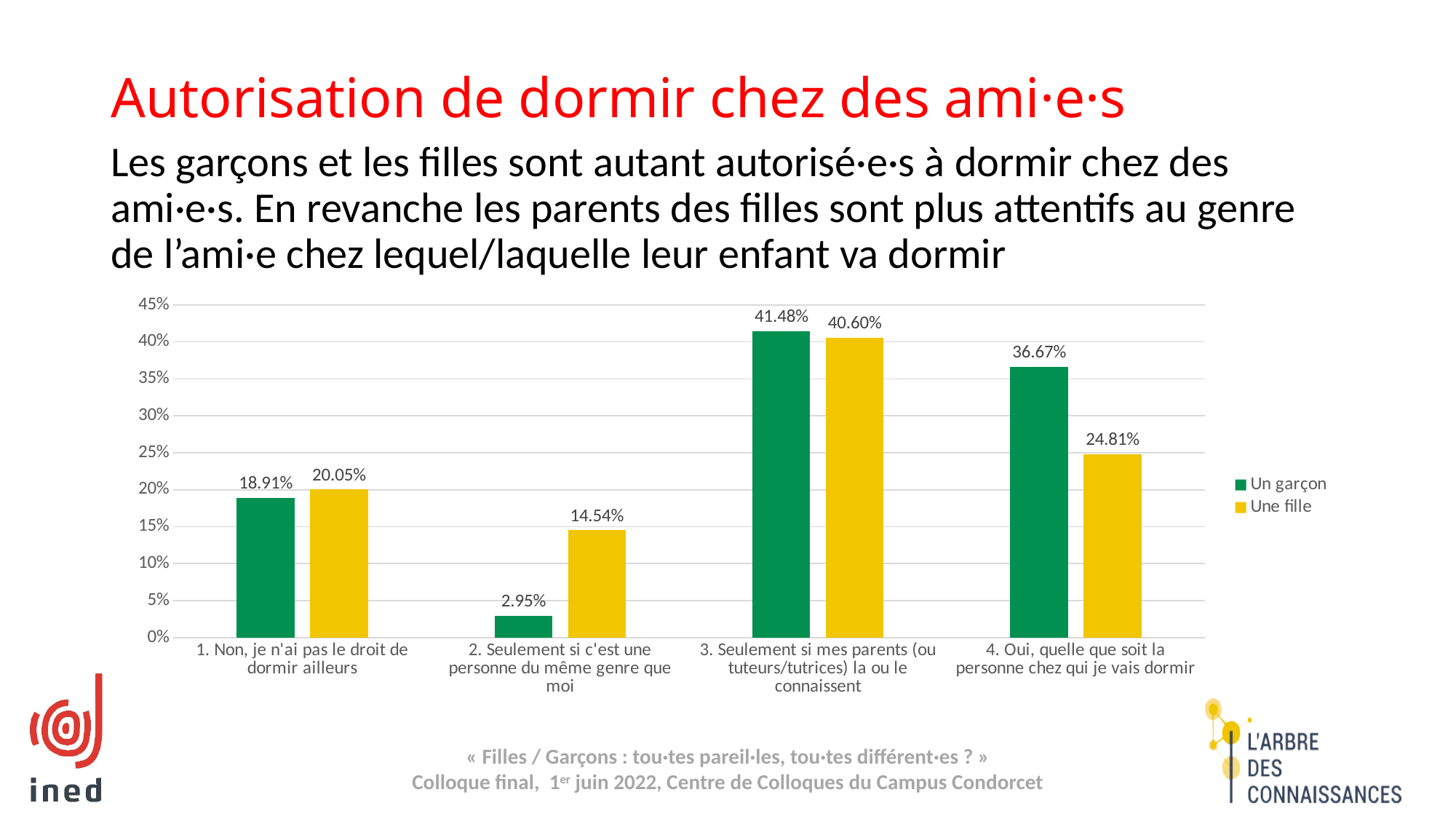
Which category has the lowest value for the "Une fille" series? 2. Seulement si c'est une personne du même genre que moi In category "4. Oui, quelle que soit la personne chez qui je vais dormir", which series has the larger value, "Un garçon" or "Une fille"? Un garçon How many series does the chart legend list? 2 What is the difference between the "Un garçon" and "Une fille" values in category "4. Oui, quelle que soit la personne chez qui je vais dormir"? 11.86 percentage points What type of chart is shown on the slide? Bar chart What is the value for "Un garçon" in category "2. Seulement si c'est une personne du même genre que moi"? 2.95% Which category has the highest value for the "Un garçon" series? 3. Seulement si mes parents (ou tuteurs/tutrices) la ou le connaissent What is the value for "Une fille" in category "4. Oui, quelle que soit la personne chez qui je vais dormir"? 24.81% What is the value for "Une fille" in category "1. Non, je n'ai pas le droit de dormir ailleurs"? 20.05% How many categories are shown on the x axis of the chart? 4 Which colour represents the "Une fille" series in the chart? Yellow What is the difference between the "Une fille" and "Un garçon" values in category "2. Seulement si c'est une personne du même genre que moi"? 11.59 percentage points